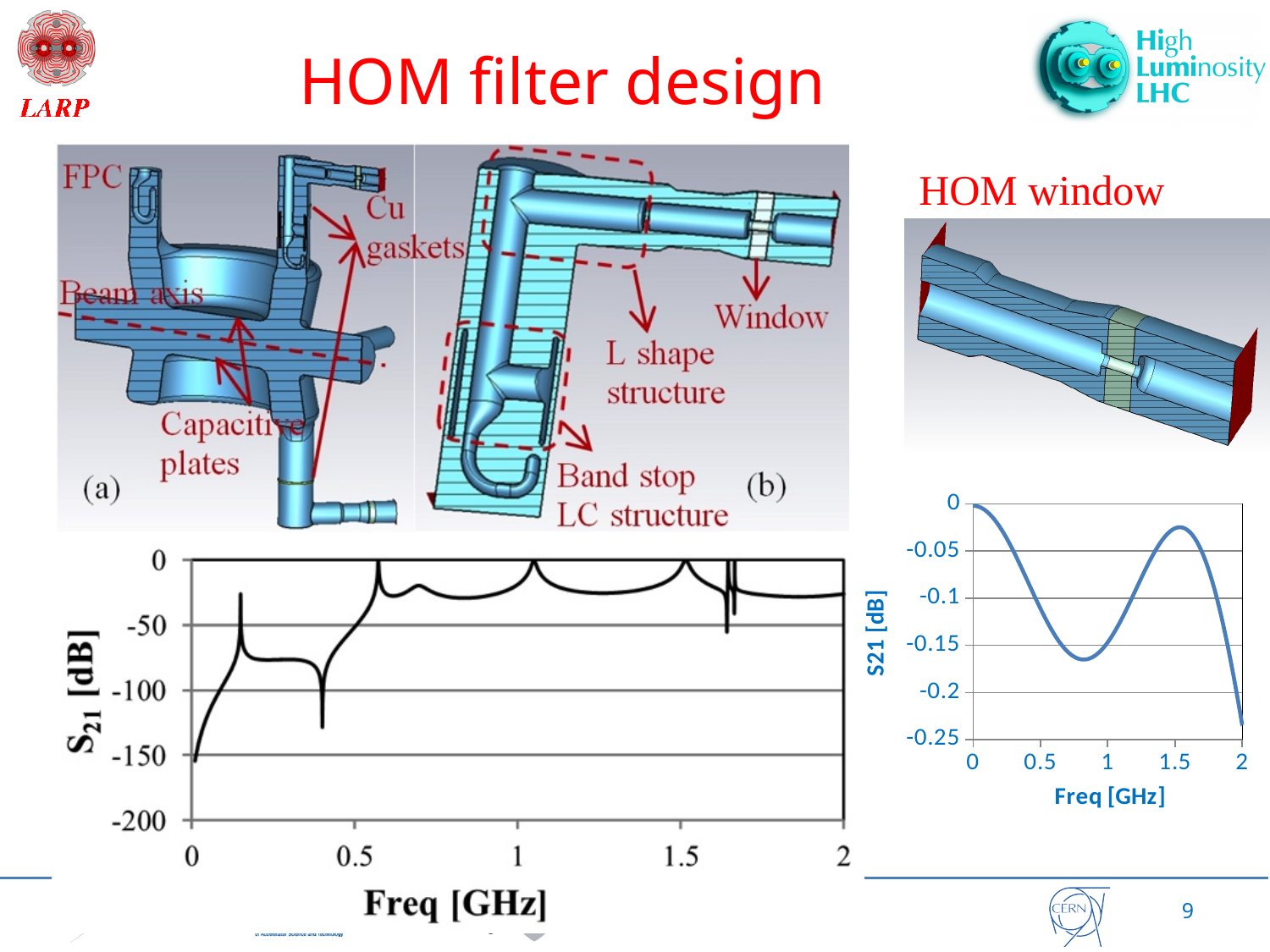
In the HOM window chart on the right, is the S21 value at 1.5 GHz greater or less than -0.05? greater In the bottom-left chart, what is the label of the y axis? S21 [dB] In the HOM window chart on the right, is the S21 value at 2 GHz greater or less than -0.2? less What kind of chart is the large chart at the bottom left of the slide? line chart In the HOM window chart on the right, does the S21 value rise or fall between 1.5 GHz and 2 GHz? fall In the bottom-left chart, is the S21 value at 0.4 GHz greater or less than -100? less What kind of chart is the chart under the 'HOM window' heading on the right? line chart In the bottom-left chart, does the S21 value rise or fall between 0 GHz and 0.15 GHz? rise How many charts are shown on the slide? 2 In the bottom-left chart, what is the label of the x axis? Freq [GHz]